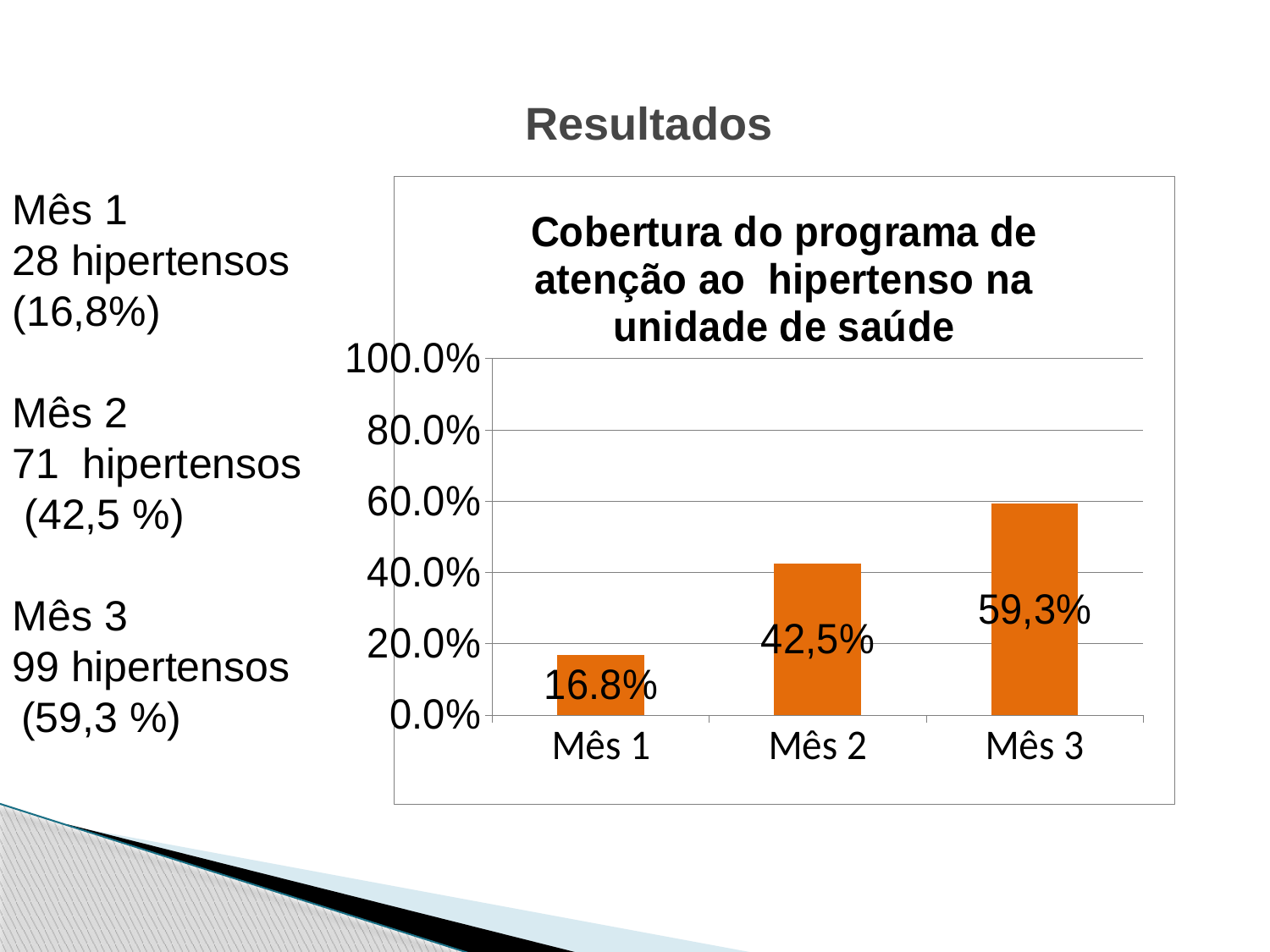
Which month has the highest coverage value? Mês 3 What is the value shown for Mês 3? 59,3% What is the value shown for Mês 1? 16.8% What is the value shown for Mês 2? 42,5% What kind of chart is shown on the slide? bar chart Is the value for Mês 3 greater or less than 40.0%? greater Which is larger, the value for Mês 2 or the value for Mês 1? Mês 2 How many categories are shown on the x axis? 3 Do the values rise or fall from Mês 1 to Mês 3? rise Which month has the lowest coverage value? Mês 1 Is the value for Mês 1 greater or less than 20.0%? less What is the difference between the values for Mês 3 and Mês 2? 16,8%